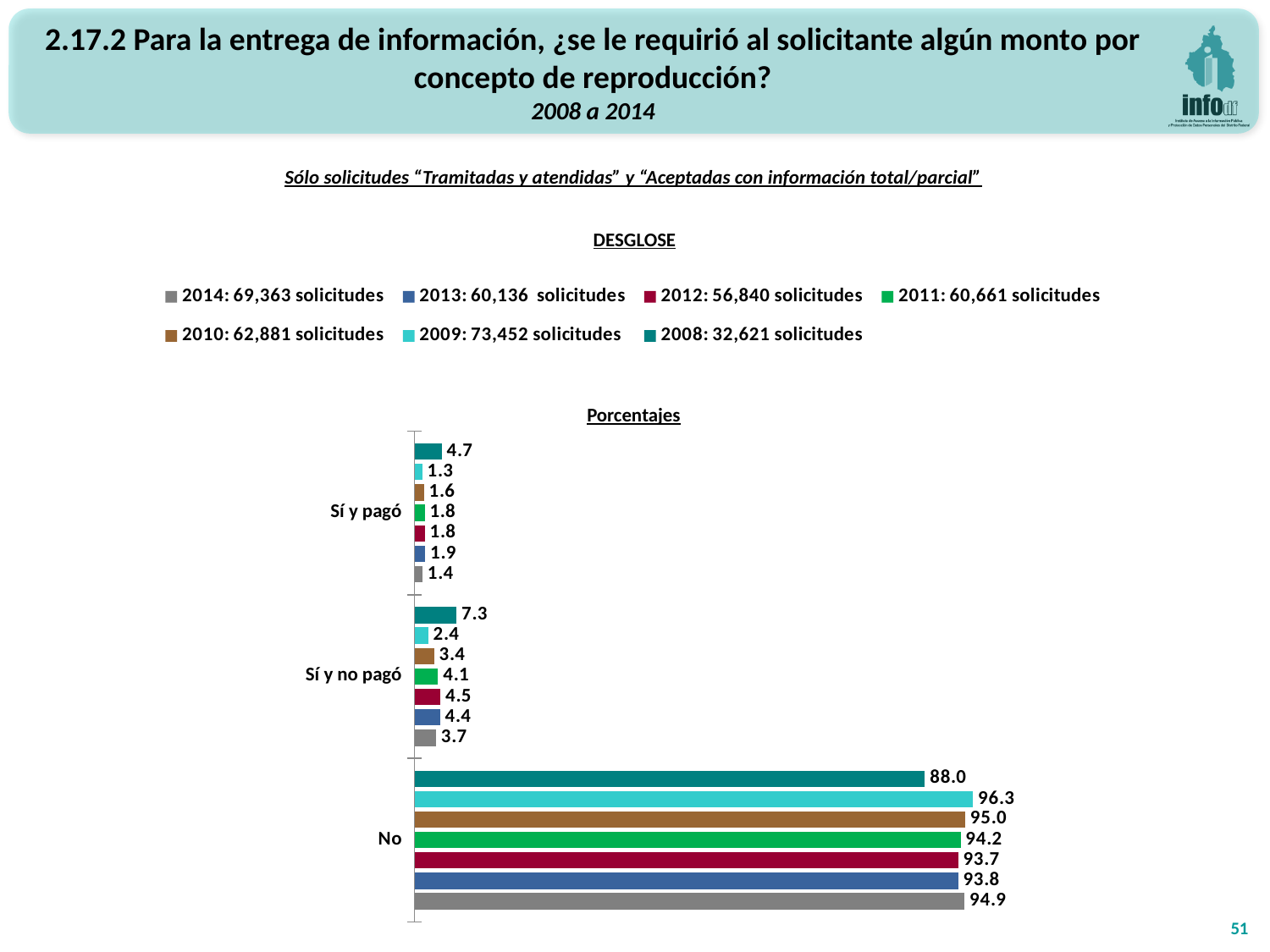
What is the value for 2008 in the "No" category? 88.0 Which year has the lowest value in the "Sí y pagó" category? 2009 What is the value for 2014 in the "Sí y pagó" category? 1.4 What is the value for 2012 in the "Sí y no pagó" category? 4.5 What is the difference between the 2009 and 2008 values in the "No" category? 8.3 How many categories are shown on the chart? 3 Which year has the highest value in the "Sí y no pagó" category? 2008 How many series does the legend list? 7 Which is larger in the "Sí y no pagó" category: the value for 2010 or the value for 2011? 2011 What is the value for 2009 in the "No" category? 96.3 What kind of chart is shown on the slide? Bar chart Which year has the lowest value in the "No" category? 2008